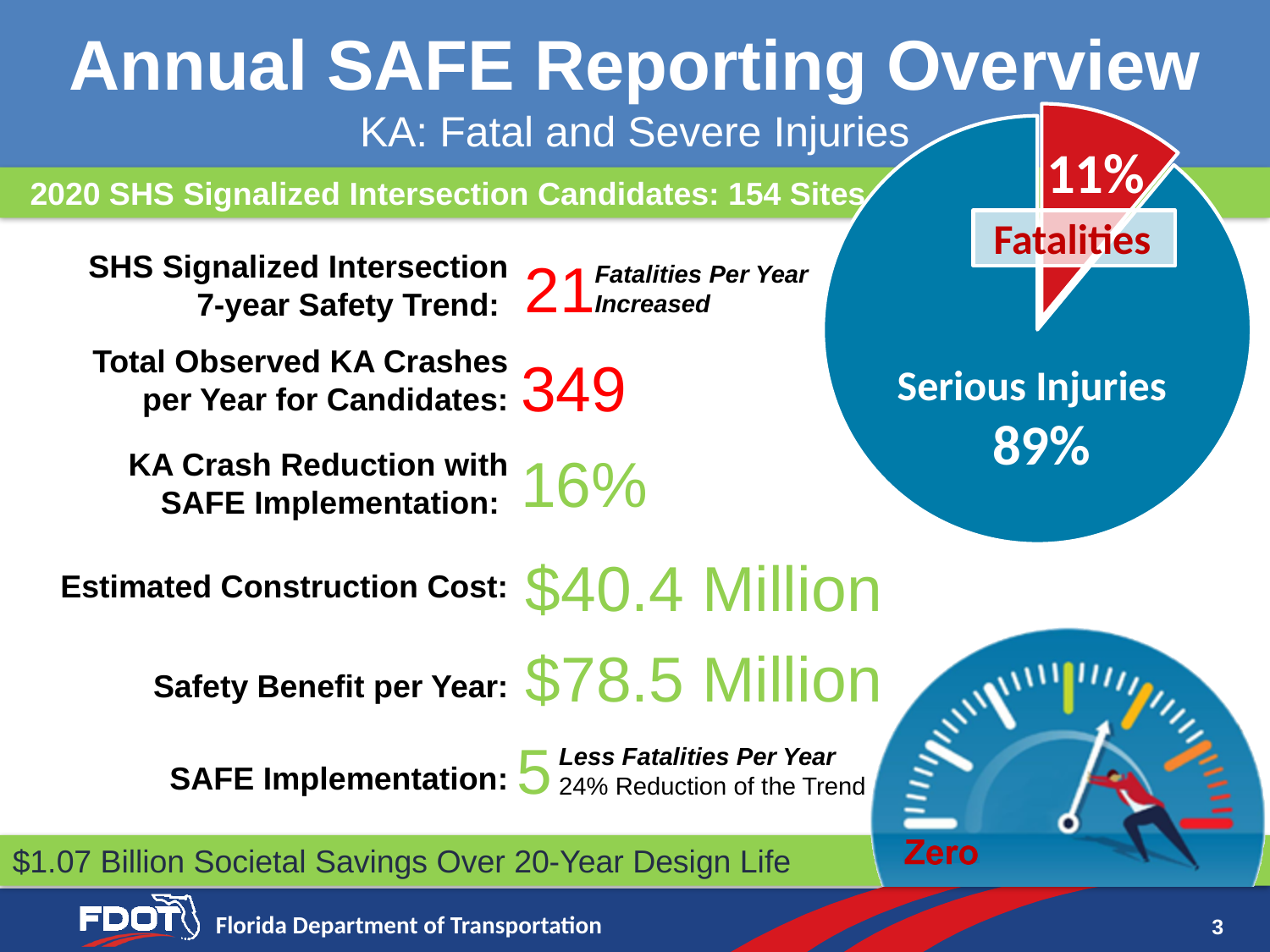
What colour is the Serious Injuries slice in the pie chart? blue What colour is the Fatalities slice in the pie chart? red What share of the pie chart is Serious Injuries? 89% Which slice of the pie chart is the smallest? Fatalities What share of the pie chart is Fatalities? 11% What kind of chart is shown on the slide? pie chart Which is larger in the pie chart, Fatalities or Serious Injuries? Serious Injuries Which slice of the pie chart is the largest? Serious Injuries What is the total of the two slices in the pie chart? 100% What is the difference in percentage points between the Serious Injuries slice and the Fatalities slice? 78 How many slices does the pie chart have? 2